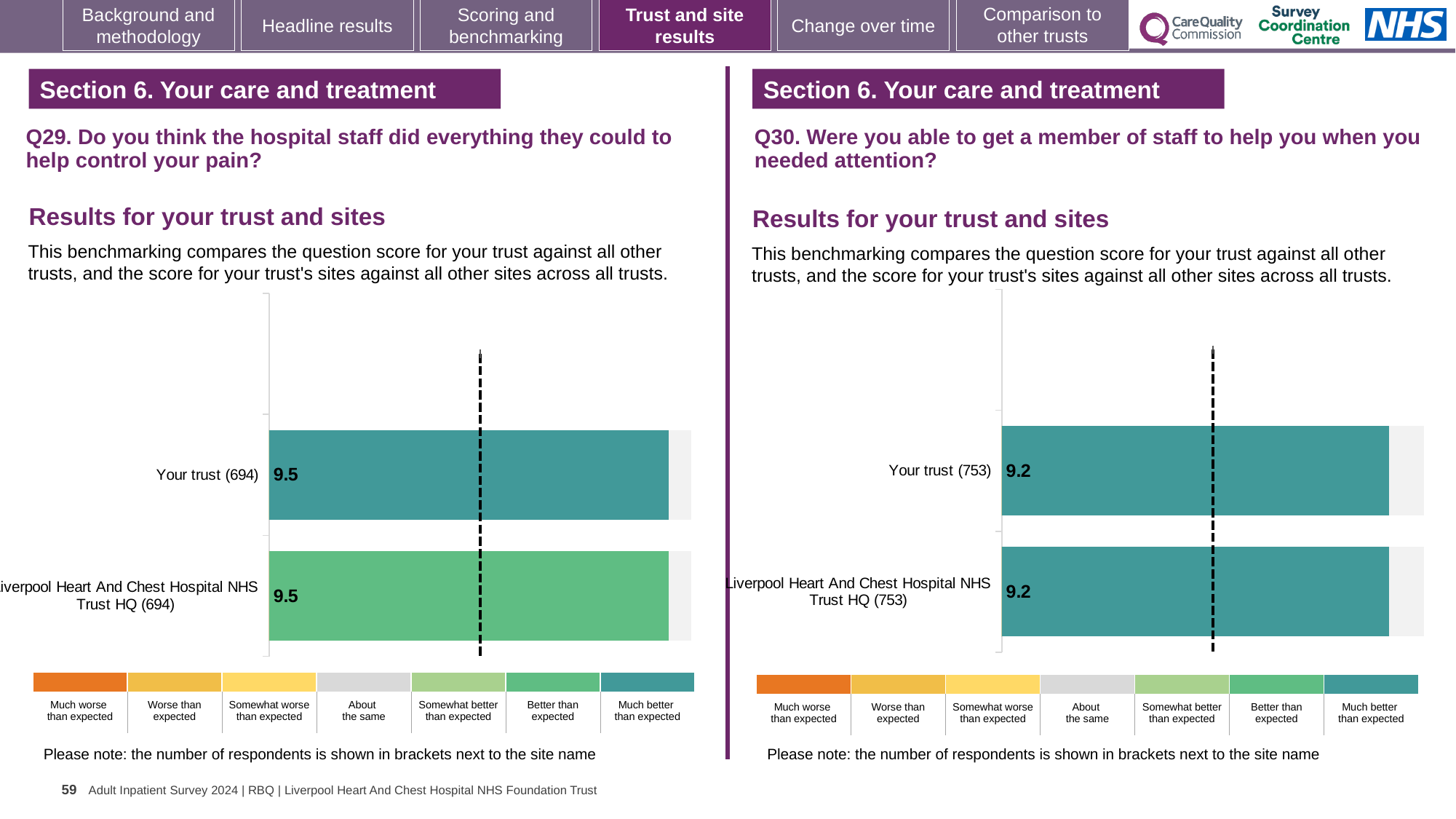
On the Q30 chart, what is the difference between the score for Your trust and the score for Liverpool Heart And Chest Hospital NHS Trust HQ? 0.0 On the Q29 chart, which benchmark category does the colour of the Liverpool Heart And Chest Hospital NHS Trust HQ bar correspond to in the key? Better than expected How many bars are plotted on the Q29 chart? 2 On the Q29 chart, what is the difference between the score for Your trust and the score for Liverpool Heart And Chest Hospital NHS Trust HQ? 0.0 How many bars are plotted on the Q30 chart? 2 Is the score for Your trust on the Q30 chart higher or lower than the score for Your trust on the Q29 chart? Lower On the Q29 chart, what is the score for Your trust (694)? 9.5 On the Q29 chart, what is the score for Liverpool Heart And Chest Hospital NHS Trust HQ (694)? 9.5 How many respondents are shown in brackets for Your trust on the Q30 chart? 753 On the Q30 chart, what is the score for Your trust (753)? 9.2 What type of chart is used on the Q29 chart? Bar chart On the Q30 chart, what is the score for Liverpool Heart And Chest Hospital NHS Trust HQ (753)? 9.2